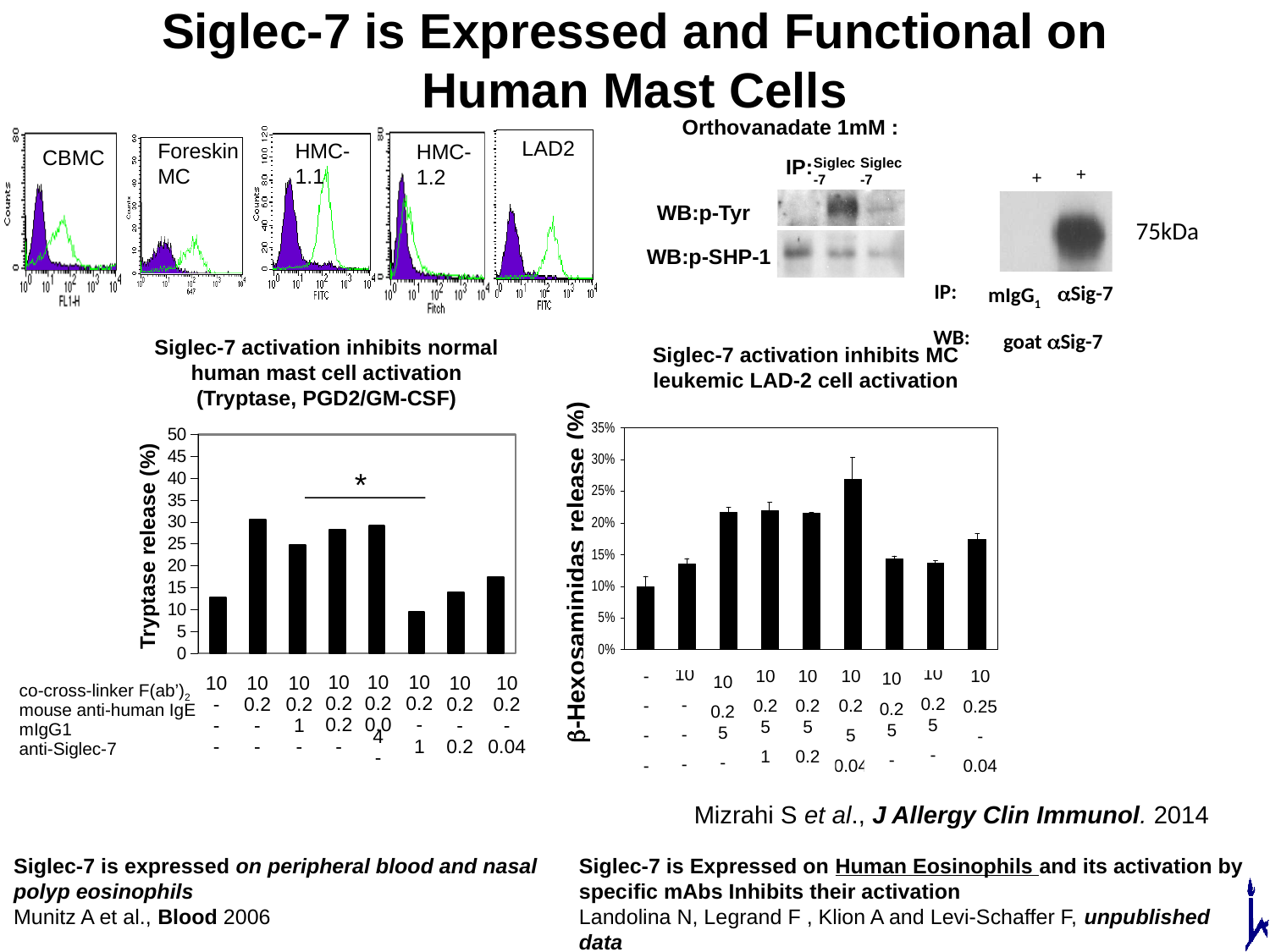
In the 'β-Hexosaminidas release (%)' chart on the right, which bar is the highest? the sixth bar from the left In the 'β-Hexosaminidas release (%)' chart on the right, is the value of the sixth bar greater or less than 25%? greater In the 'Tryptase release (%)' chart on the left, which bar is the highest? the second bar from the left In the 'Tryptase release (%)' chart on the left, is the value of the first bar greater or less than 15? less How many bars are plotted in the 'Tryptase release (%)' chart on the left? 8 What kind of chart is the 'Tryptase release (%)' chart on the left? bar chart In the 'Tryptase release (%)' chart on the left, is the value of the second bar greater or less than 25? greater What is the y-axis title of the bar chart on the left? Tryptase release (%) How many bars are plotted in the 'β-Hexosaminidas release (%)' chart on the right? 9 In the 'Tryptase release (%)' chart on the left, which bar is the lowest? the sixth bar from the left In the 'β-Hexosaminidas release (%)' chart on the right, which bar is the lowest? the first bar from the left In the 'Tryptase release (%)' chart on the left, which is larger, the first bar or the second bar? the second bar